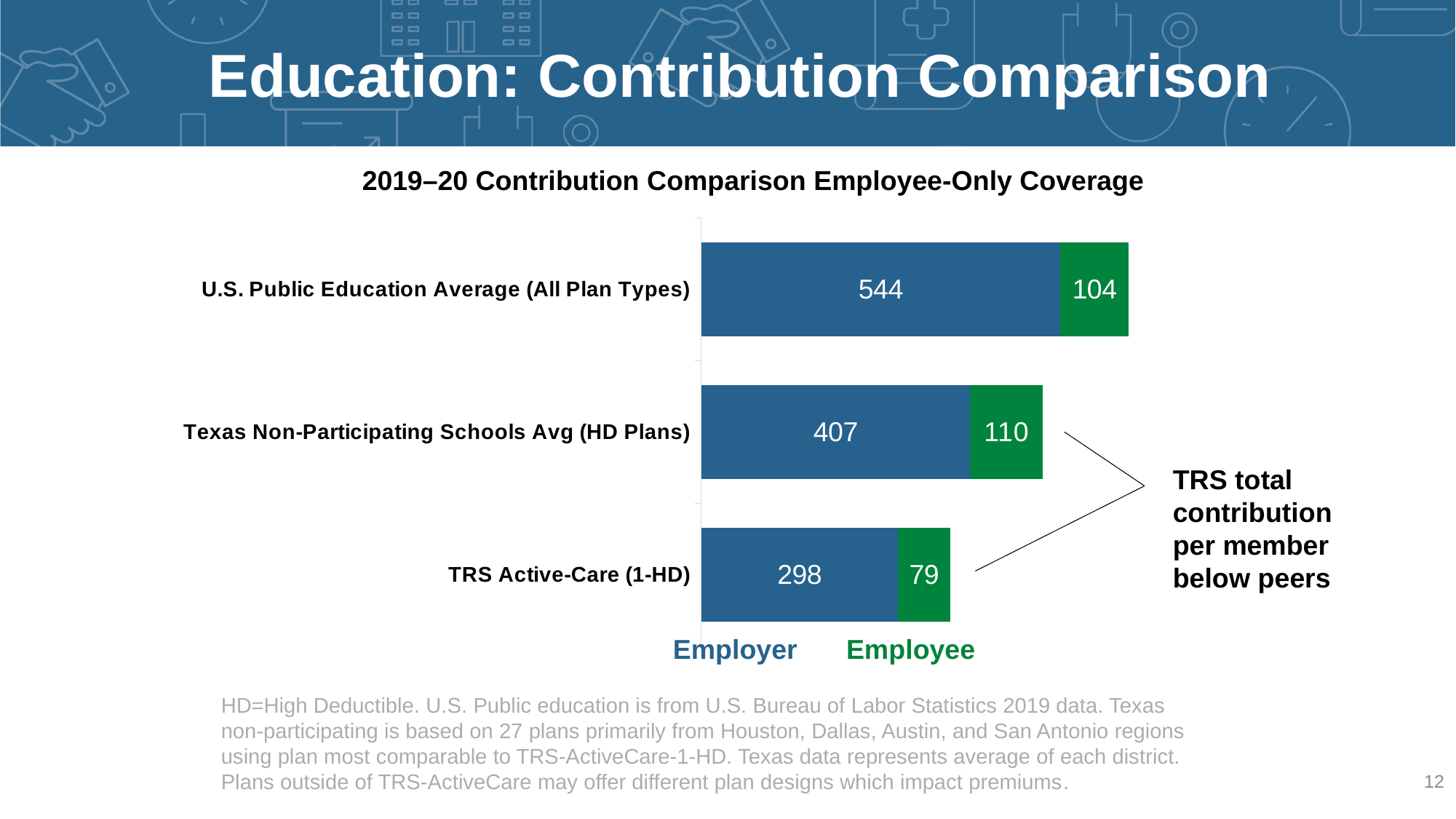
Which is larger, the Employee contribution for Texas Non-Participating Schools Avg (HD Plans) or for U.S. Public Education Average (All Plan Types)? Texas Non-Participating Schools Avg (HD Plans) What is the Employee contribution for Texas Non-Participating Schools Avg (HD Plans)? 110 What is the Employee contribution for TRS Active-Care (1-HD)? 79 What is the total contribution (Employer plus Employee) for Texas Non-Participating Schools Avg (HD Plans)? 517 Which category has the lowest Employee contribution? TRS Active-Care (1-HD) What type of chart is shown on the slide? Stacked bar chart How many series does the legend list? 2 Which category has the highest Employer contribution? U.S. Public Education Average (All Plan Types) How many categories are shown in the chart? 3 What is the difference between the Employer contributions for U.S. Public Education Average (All Plan Types) and TRS Active-Care (1-HD)? 246 What is the Employer contribution for U.S. Public Education Average (All Plan Types)? 544 What is the total contribution (Employer plus Employee) for TRS Active-Care (1-HD)? 377